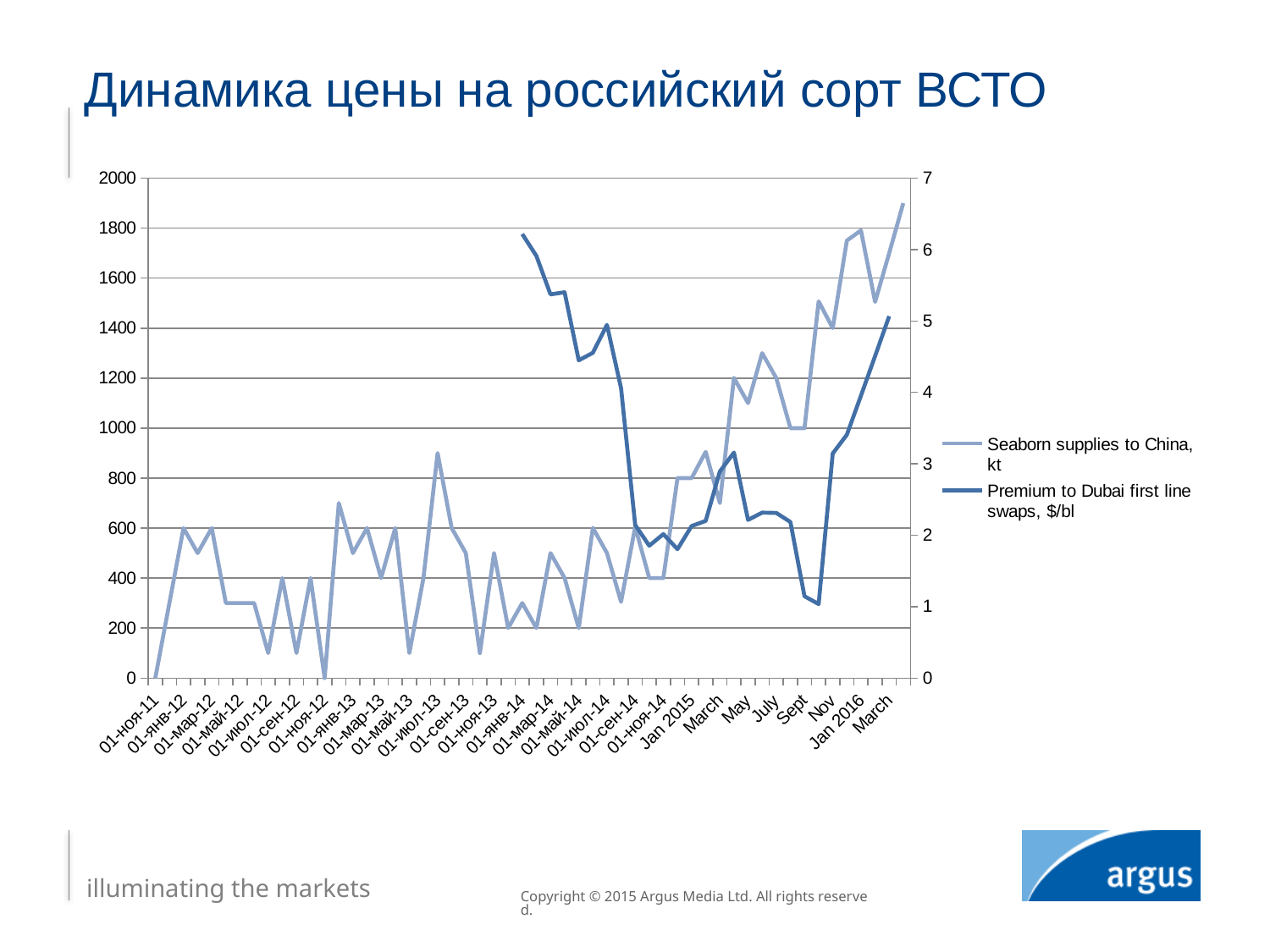
Which series is plotted in the darker blue line? Premium to Dubai first line swaps, $/bl Is the value of Seaborn supplies to China at 01-янв-12 greater or less than 400? greater How many series does the legend list? 2 Does Premium to Dubai first line swaps rise or fall between 01-янв-14 and 01-ноя-14? fall What is the title of the slide chart? Динамика цены на российский сорт ВСТО What kind of chart is shown on the slide? line chart At which date does Premium to Dubai first line swaps reach its highest value? 01-янв-14 Which is larger: Seaborn supplies to China at Jan 2016 or at 01-янв-12? Jan 2016 Is the value of Seaborn supplies to China at March (2016) greater or less than 1600? greater Is the value of Premium to Dubai first line swaps at Nov (2015) greater or less than 2? greater